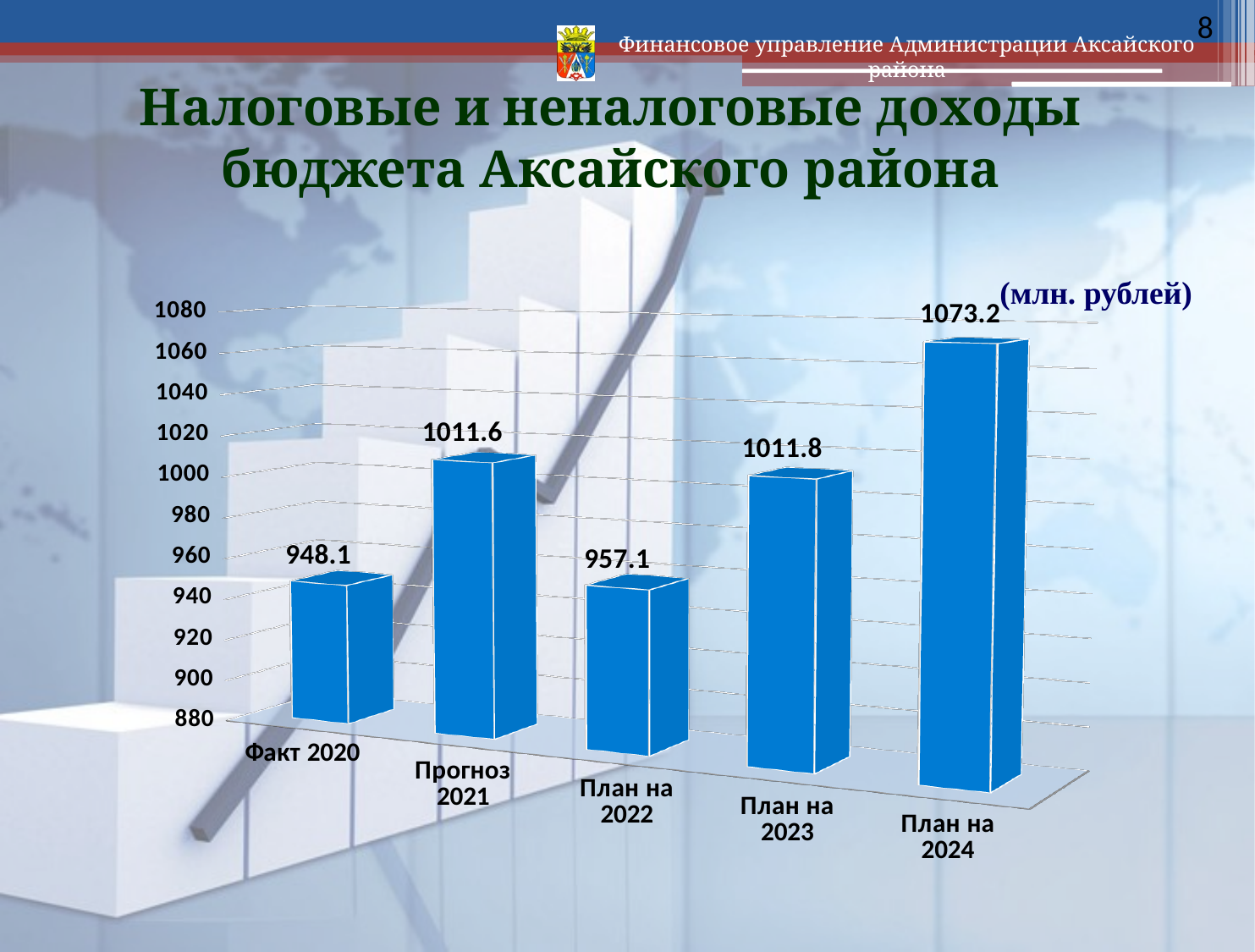
What is the value for План на 2023? 1011.8 How many categories are shown on the chart? 5 Which is larger, the value for Прогноз 2021 or the value for План на 2022? Прогноз 2021 Which category has the lowest value? Факт 2020 What is the difference between the values for План на 2024 and Факт 2020? 125.1 What is the value for Прогноз 2021? 1011.6 What is the value for План на 2024? 1073.2 What is the value for Факт 2020? 948.1 What kind of chart is shown on the slide? Bar chart What is the value for План на 2022? 957.1 In what units are the values on the chart given? млн. рублей Which category has the highest value? План на 2024